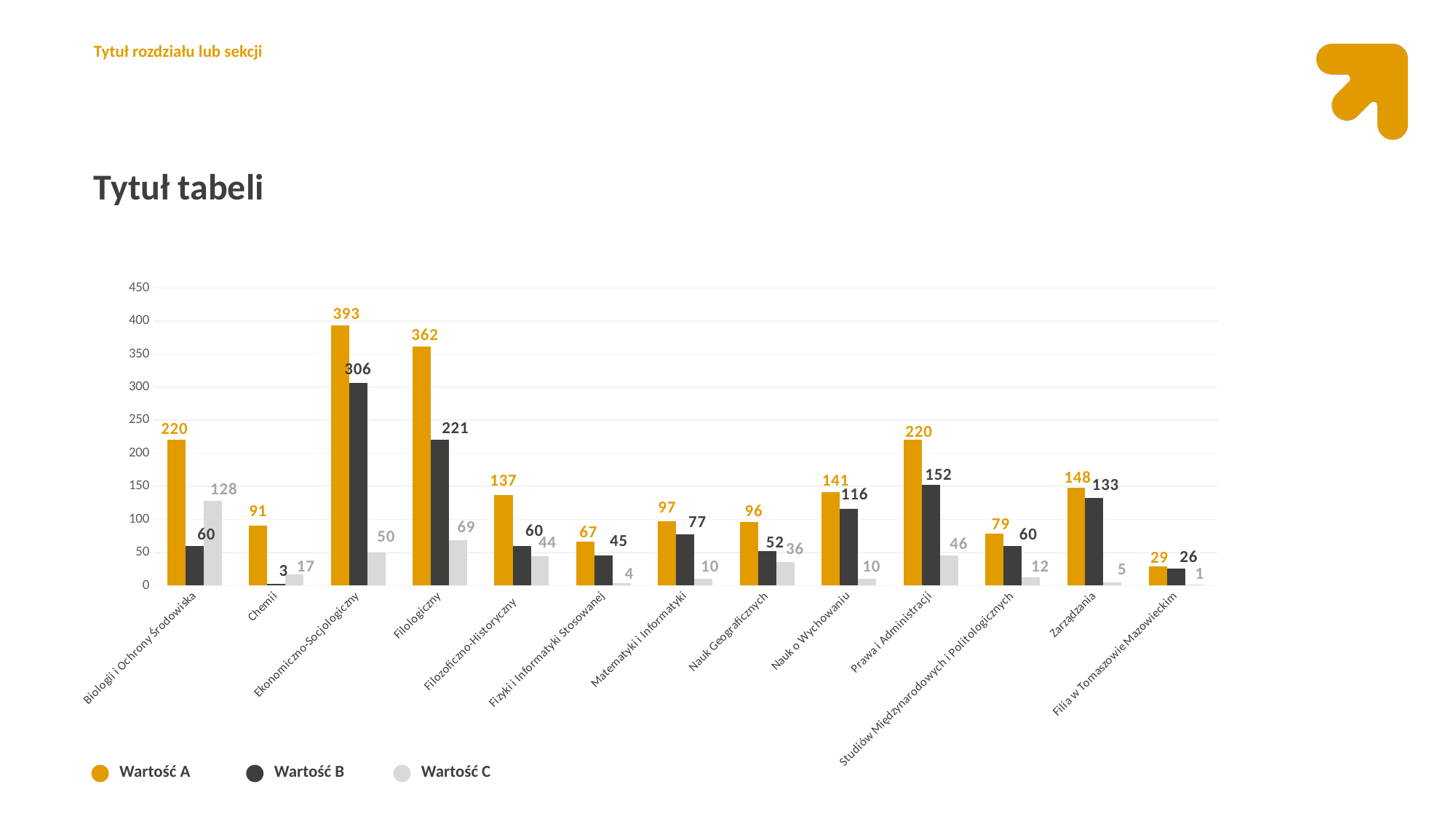
Which category has the highest value of Wartość B? Ekonomiczno-Socjologiczny Which category has the lowest value of Wartość C? Filia w Tomaszowie Mazowieckim What is the value of Wartość A for Ekonomiczno-Socjologiczny? 393 Is the value of Wartość A for Nauk o Wychowaniu greater or less than 100? greater Which is larger: Wartość C for Chemii or Wartość C for Nauk Geograficznych? Wartość C for Nauk Geograficznych What is the value of Wartość C for Biologii i Ochrony Środowiska? 128 What is the difference between Wartość A and Wartość B for Filologiczny? 141 What kind of chart is shown on the slide? bar chart What is the title of the chart? Tytuł tabeli How many series does the legend list? 3 How many categories are shown on the x axis of the chart? 13 What is the value of Wartość B for Prawa i Administracji? 152